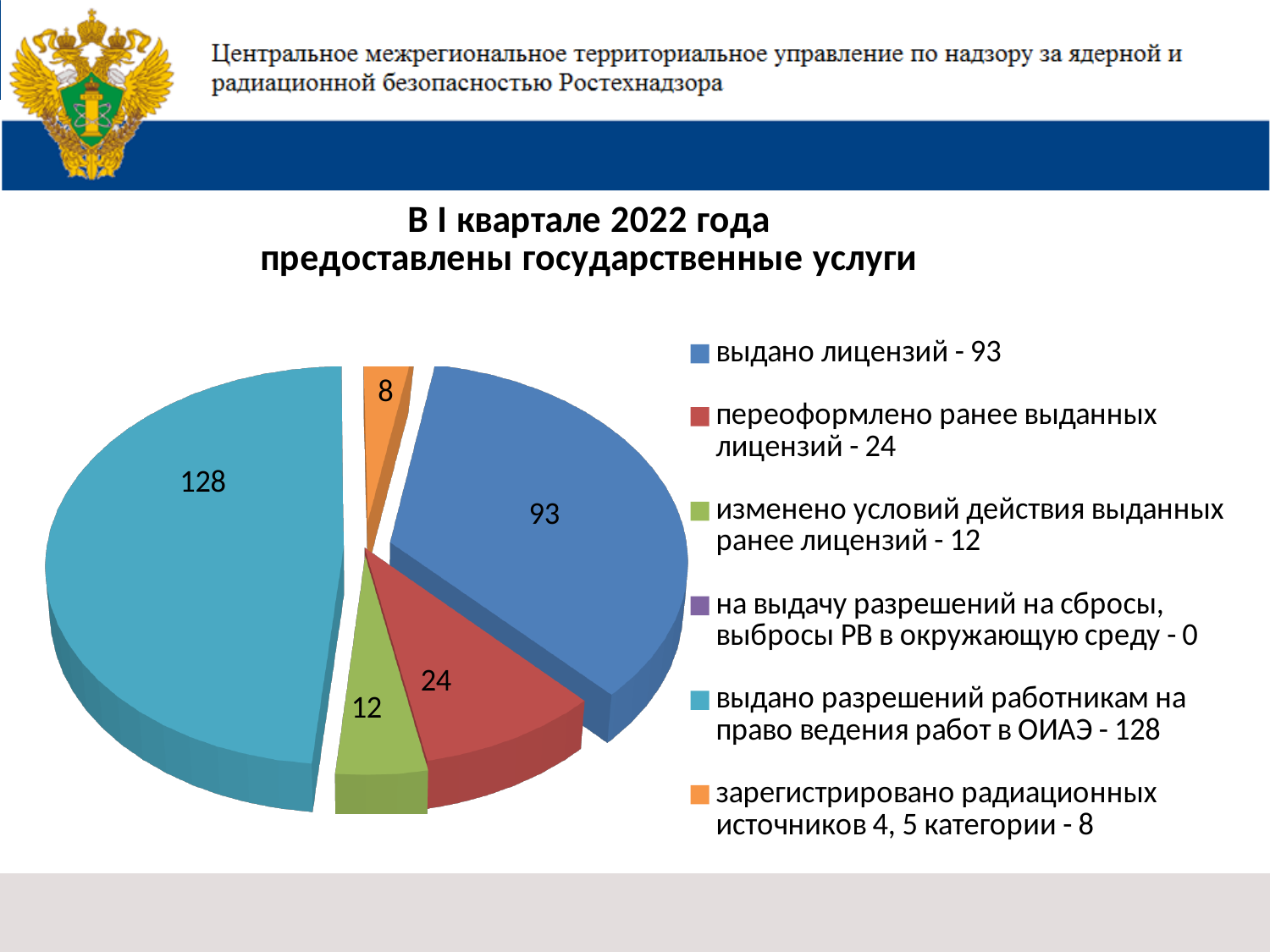
How many entries does the chart legend list? 6 What is the value for "зарегистрировано радиационных источников 4, 5 категории"? 8 What is the value for "переоформлено ранее выданных лицензий"? 24 What is the value for "выдано разрешений работникам на право ведения работ в ОИАЭ"? 128 What colour is the slice for "выдано лицензий - 93"? blue What is the value for "изменено условий действия выданных ранее лицензий"? 12 Which is larger: the value for "переоформлено ранее выданных лицензий" or the value for "изменено условий действия выданных ранее лицензий"? переоформлено ранее выданных лицензий What is the value for "выдано лицензий"? 93 Which legend category has the smallest value? на выдачу разрешений на сбросы, выбросы РВ в окружающую среду - 0 What type of chart is shown on the slide? pie chart What is the difference between the value for "выдано разрешений работникам на право ведения работ в ОИАЭ" and the value for "выдано лицензий"? 35 Which category has the largest value in the pie chart? выдано разрешений работникам на право ведения работ в ОИАЭ - 128